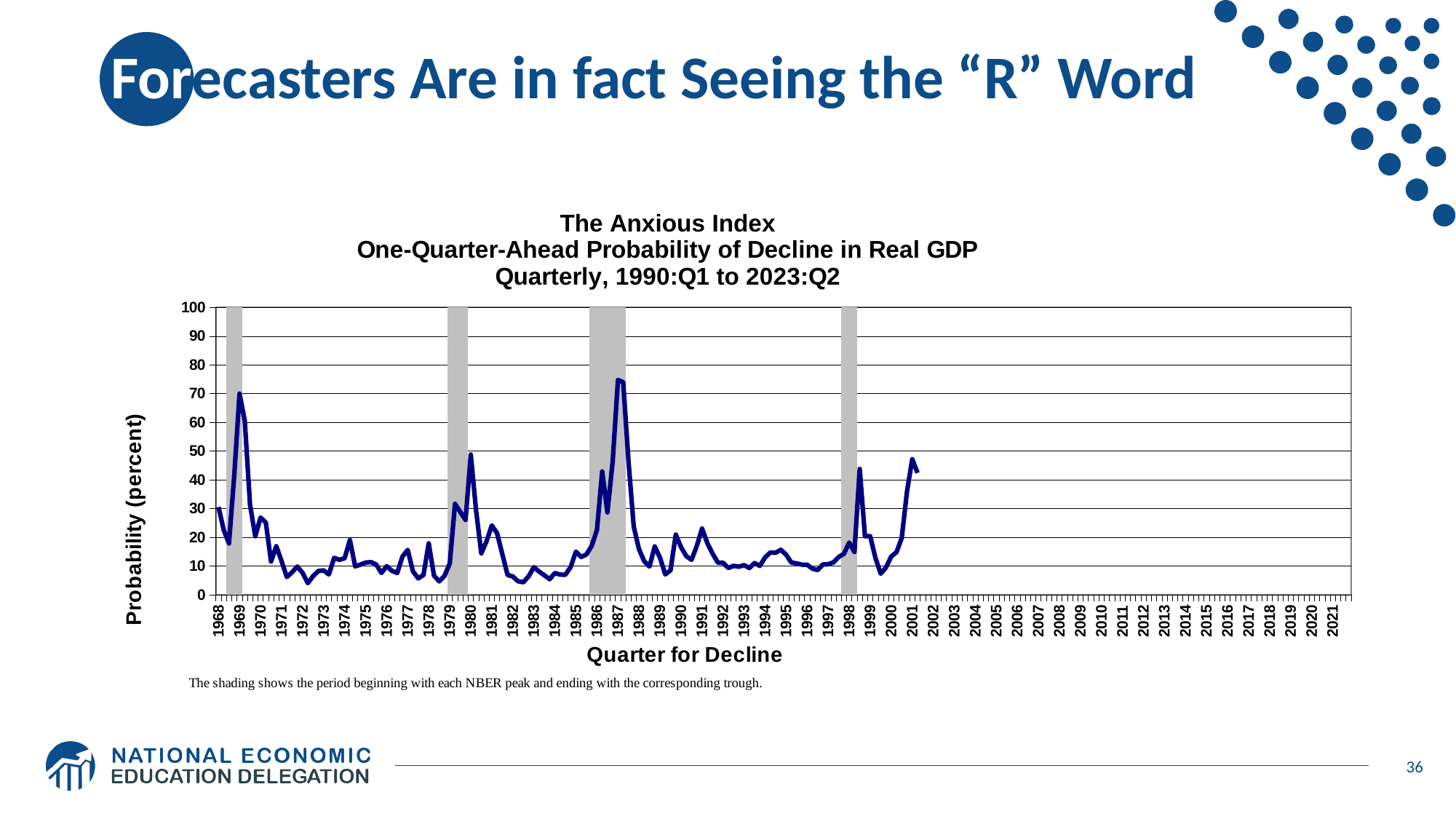
What is the label on the vertical axis of the chart? Probability (percent) Is the peak value of the line around 1980 greater or less than 40? greater What kind of chart is shown on the slide? line chart Is the value of the line around 1972 greater or less than 10? less How many shaded recession periods are shown on the chart? 4 Which peak is higher: the one around 1969 or the one around 1987? 1987 Is the peak value of the line around 1987 greater or less than 70? greater What is the highest value shown on the vertical axis? 100 What is the title of the chart? The Anxious Index One-Quarter-Ahead Probability of Decline in Real GDP Quarterly, 1990:Q1 to 2023:Q2 Around which year on the x axis does the line reach its highest peak? 1987